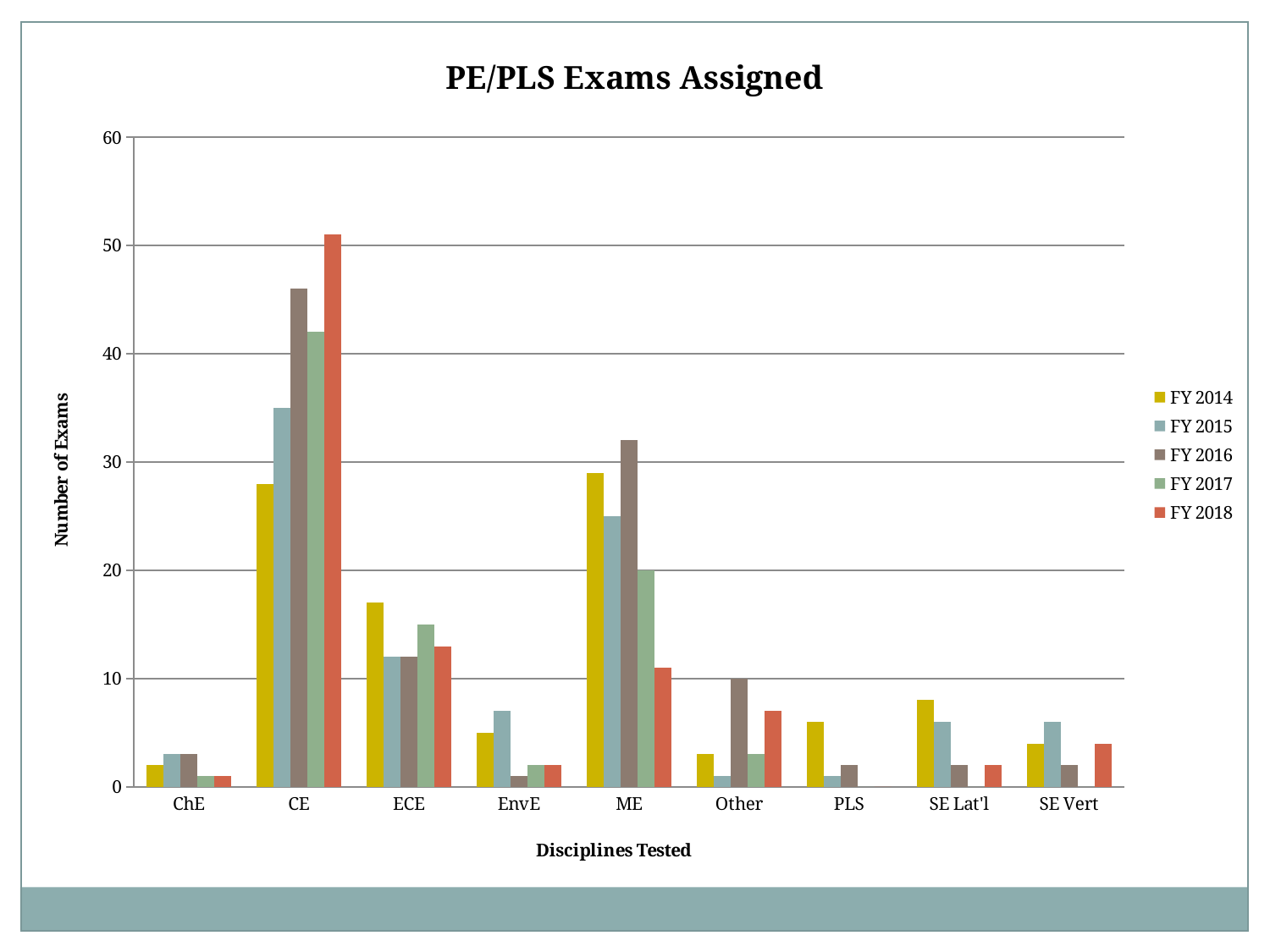
For CE, which is larger: the FY 2016 value or the FY 2017 value? FY 2016 Is the FY 2014 value for ChE greater or less than 10? less What type of chart is shown on the slide? bar chart How many series does the legend list? 5 Is the FY 2014 value for ECE greater or less than 20? less For ME, do the values rise or fall from FY 2016 to FY 2018? fall Which discipline has the highest number of exams for FY 2018? CE How many disciplines are shown on the x axis? 9 Which discipline has the tallest bar overall in the chart? CE Is the FY 2016 value for ME greater or less than 30? greater What is the title of the chart? PE/PLS Exams Assigned